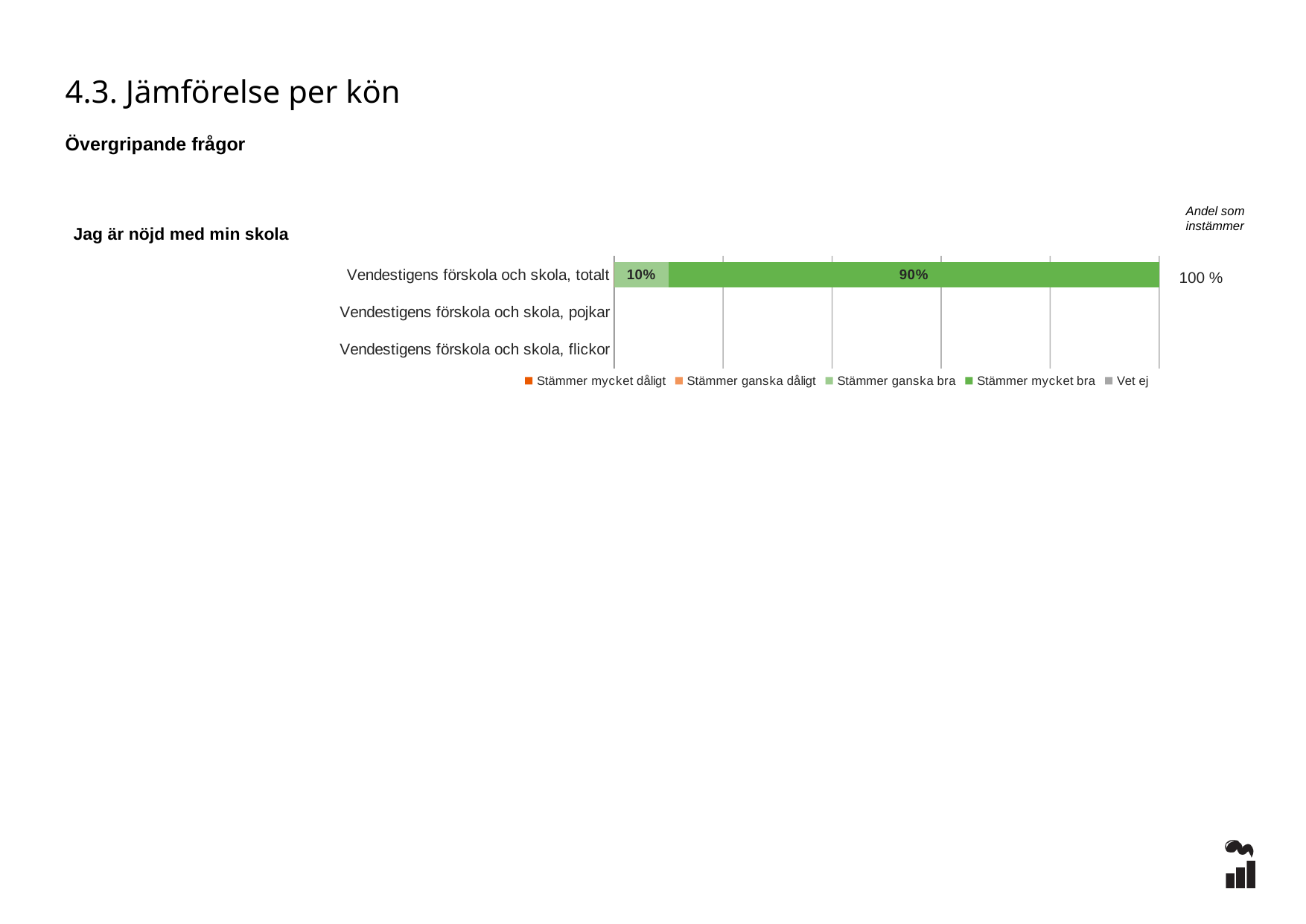
What is the value for 'Stämmer ganska bra' for Vendestigens förskola och skola, totalt? 10% What is the value for 'Stämmer mycket bra' for Vendestigens förskola och skola, totalt? 90% What is the total of the stacked bar for Vendestigens förskola och skola, totalt? 100% Which series has the largest value for Vendestigens förskola och skola, totalt? Stämmer mycket bra What 'Andel som instämmer' value is shown for Vendestigens förskola och skola, totalt? 100 % Which legend entry is shown in grey? Vet ej What kind of chart is shown on the slide? bar chart Which is larger for Vendestigens förskola och skola, totalt: 'Stämmer ganska bra' or 'Stämmer mycket bra'? Stämmer mycket bra What is the difference between the 'Stämmer mycket bra' and 'Stämmer ganska bra' values for Vendestigens förskola och skola, totalt? 80% What is the title of the chart? Jag är nöjd med min skola How many series does the legend list? 5 How many categories are listed on the vertical axis of the chart? 3